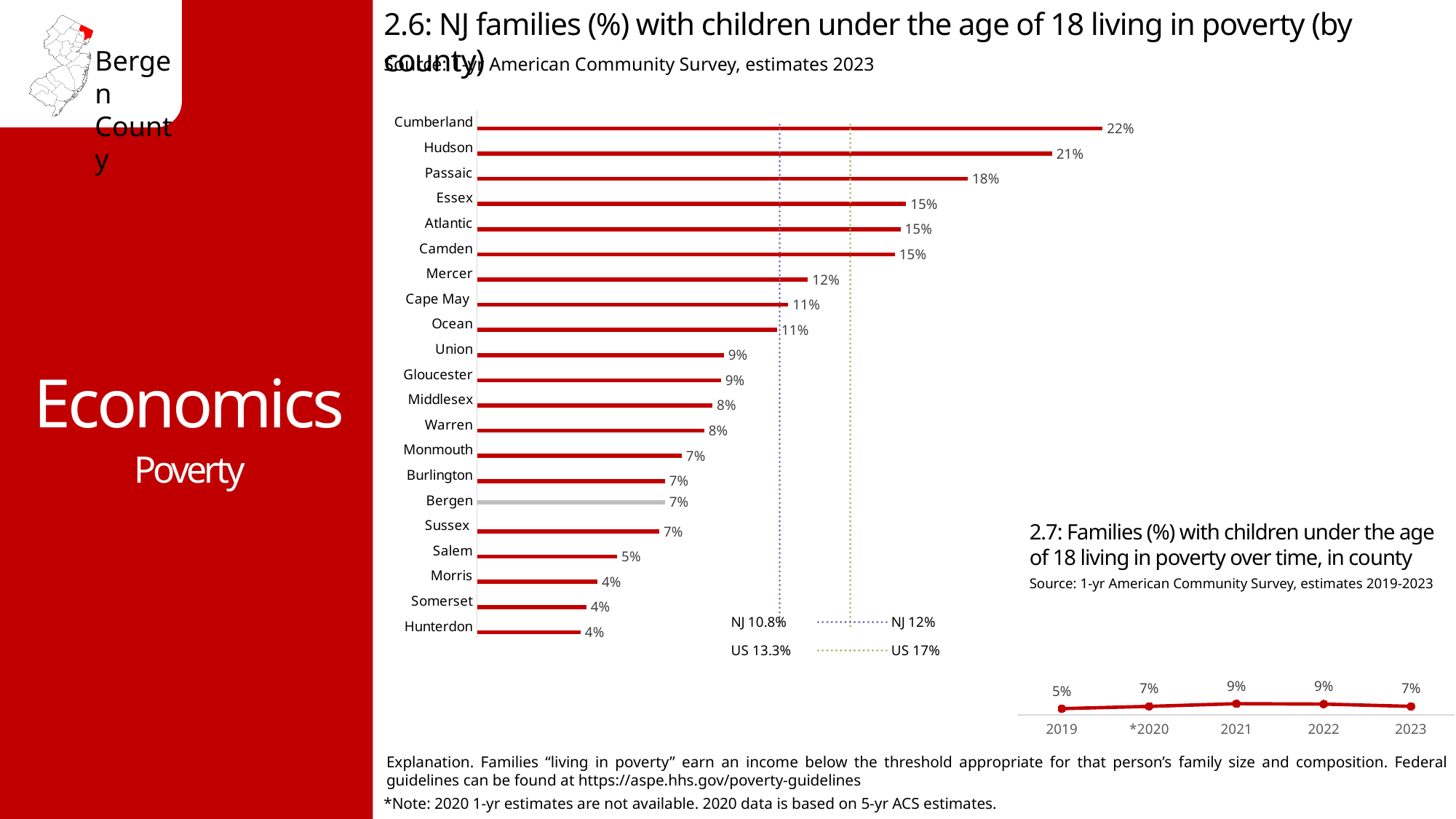
In chart 2.7, how many years are plotted? 5 In chart 2.7, what is the value for 2019? 5% What kind of chart is chart 2.7? line chart What kind of chart is chart 2.6? bar chart In chart 2.6, which county has the highest value? Cumberland In chart 2.6, what is the difference between Hudson and Passaic? 3% In chart 2.6, what is the value for Bergen? 7% In chart 2.6, how many counties are plotted? 21 In chart 2.7, what is the value for 2021? 9% In chart 2.6, which is larger, Mercer or Union? Mercer In chart 2.6, what is the value for Cumberland? 22%